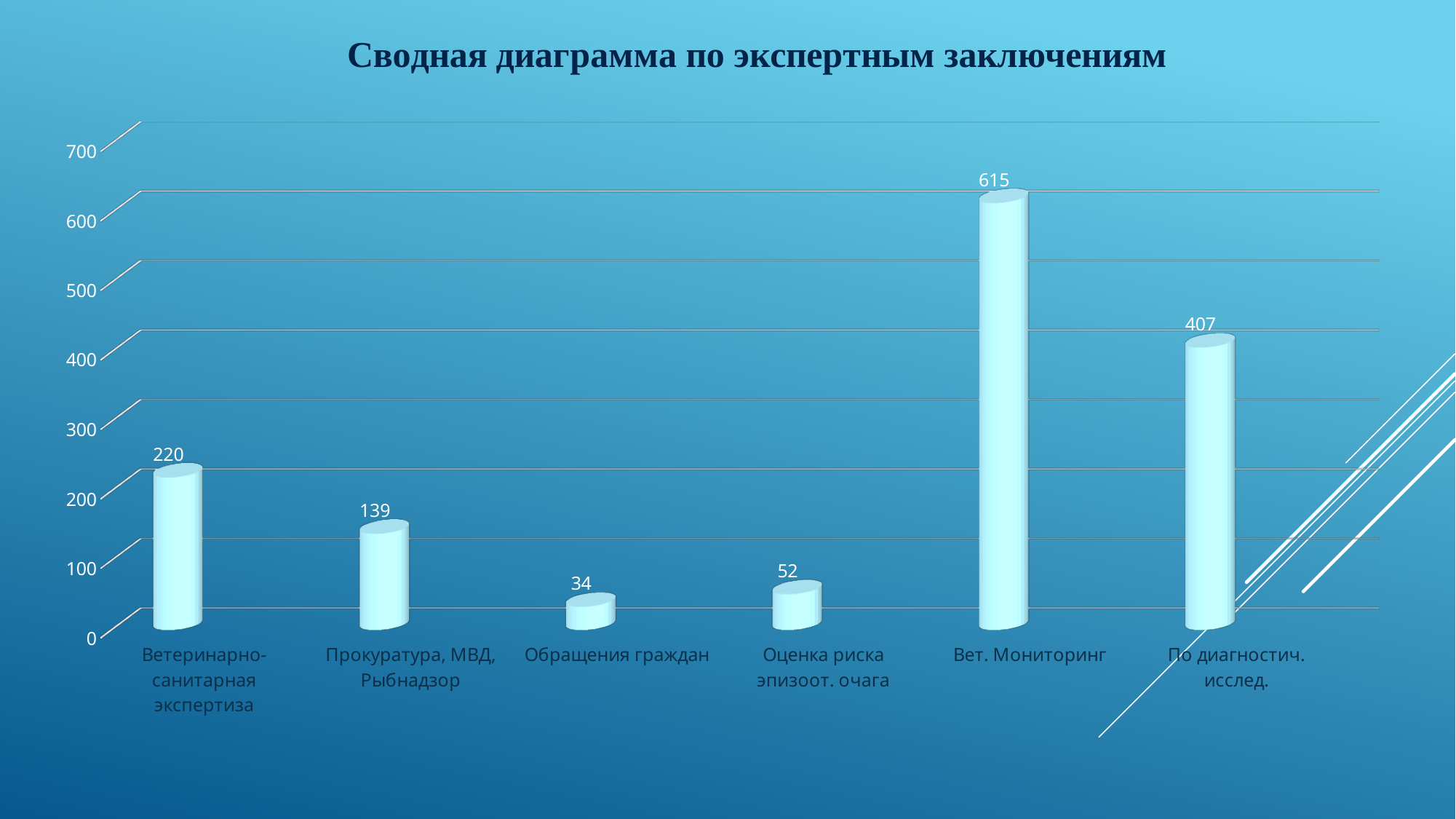
Is the value for По диагностич. исслед. greater or less than 300? greater What is the value for Ветеринарно-санитарная экспертиза? 220 What kind of chart is shown on the slide? bar chart Which is larger, the value for Прокуратура, МВД, Рыбнадзор or the value for Ветеринарно-санитарная экспертиза? Ветеринарно-санитарная экспертиза What is the difference between the values for Вет. Мониторинг and По диагностич. исслед.? 208 What is the title of the chart? Сводная диаграмма по экспертным заключениям Which category has the lowest value? Обращения граждан What is the value for Оценка риска эпизоот. очага? 52 Which category has the highest value? Вет. Мониторинг What is the value for Обращения граждан? 34 How many categories are shown on the chart? 6 What is the value for Вет. Мониторинг? 615